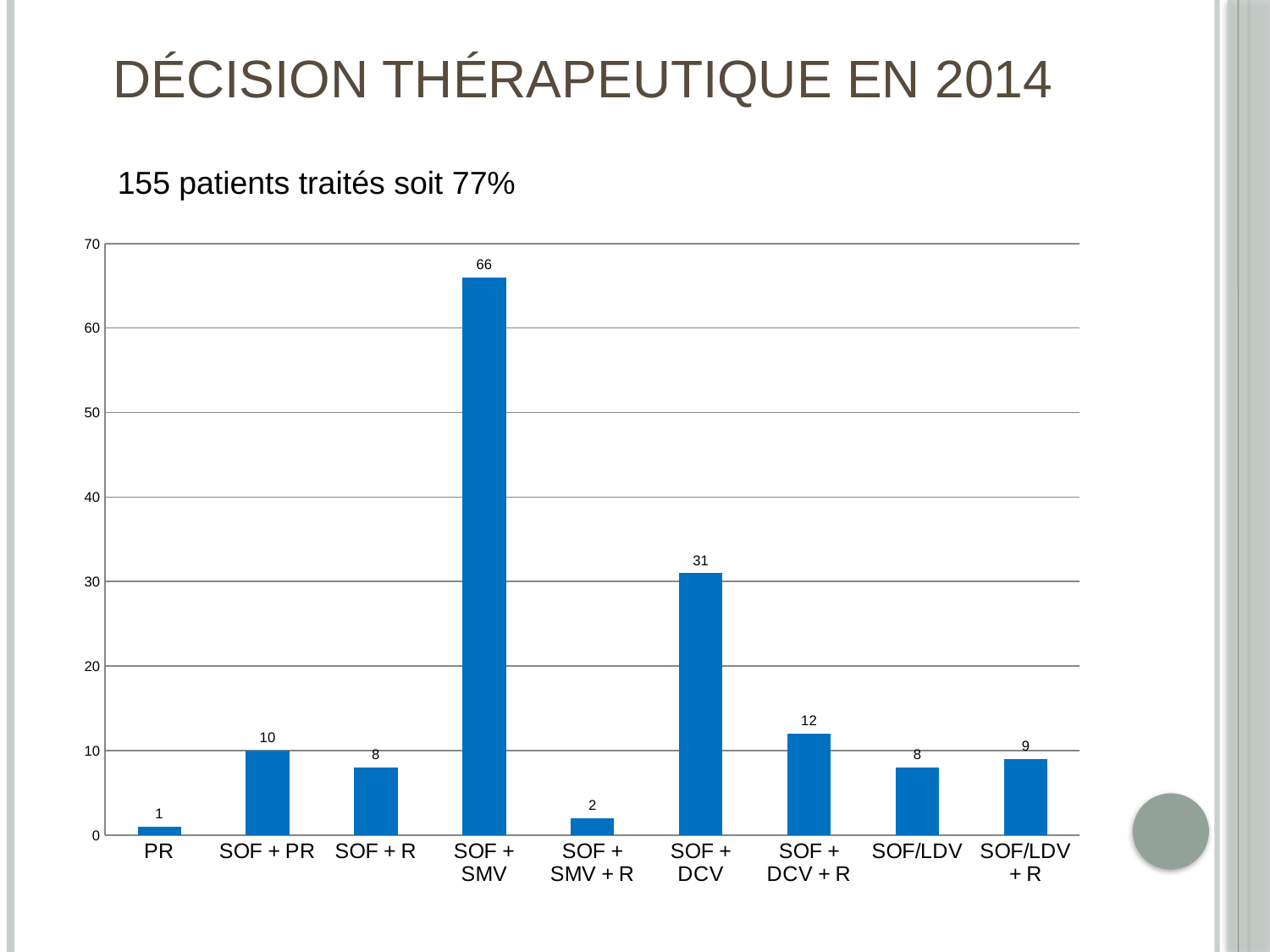
What is the difference between the values for SOF + SMV and SOF + DCV? 35 What is the value for SOF + DCV + R? 12 Is the value for SOF + DCV greater or less than 30? greater What kind of chart is shown on the slide? bar chart What is the title of the slide containing the chart? DÉCISION THÉRAPEUTIQUE EN 2014 Which is larger, the value for SOF + PR or the value for SOF/LDV + R? SOF + PR What is the value for SOF + SMV? 66 Which category has the highest value? SOF + SMV What is the difference between the values for SOF/LDV + R and SOF/LDV? 1 How many categories are shown on the x axis? 9 Which category has the lowest value? PR What is the value for PR? 1